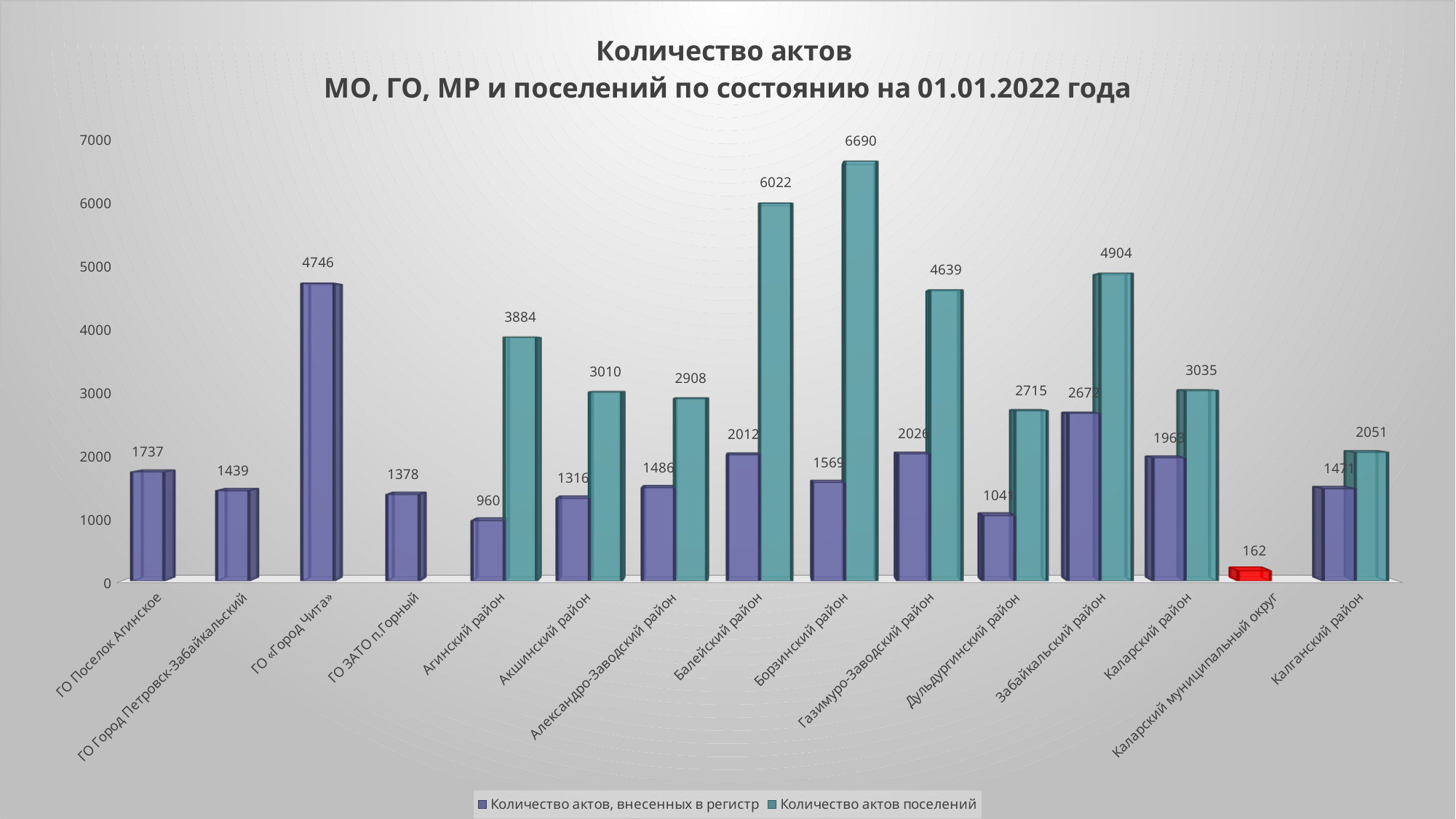
What kind of chart is shown on the slide? bar chart Is the value of «Количество актов, внесенных в регистр» for Дульдургинский район greater or less than 2000? less How many categories are shown on the x axis? 15 Which category has the highest value for «Количество актов, внесенных в регистр»? ГО «Город Чита» Which is larger: «Количество актов поселений» for Балейский район or for Забайкальский район? Балейский район Which category has the highest value for «Количество актов поселений»? Борзинский район What is the value of «Количество актов, внесенных в регистр» for ГО «Город Чита»? 4746 Which category has the lowest value for «Количество актов, внесенных в регистр»? Каларский муниципальный округ How many series does the legend list? 2 For Борзинский район, what is the difference between «Количество актов поселений» and «Количество актов, внесенных в регистр»? 5121 What is the value of «Количество актов поселений» for Агинский район? 3884 What is the value of «Количество актов поселений» for Газимуро-Заводский район? 4639